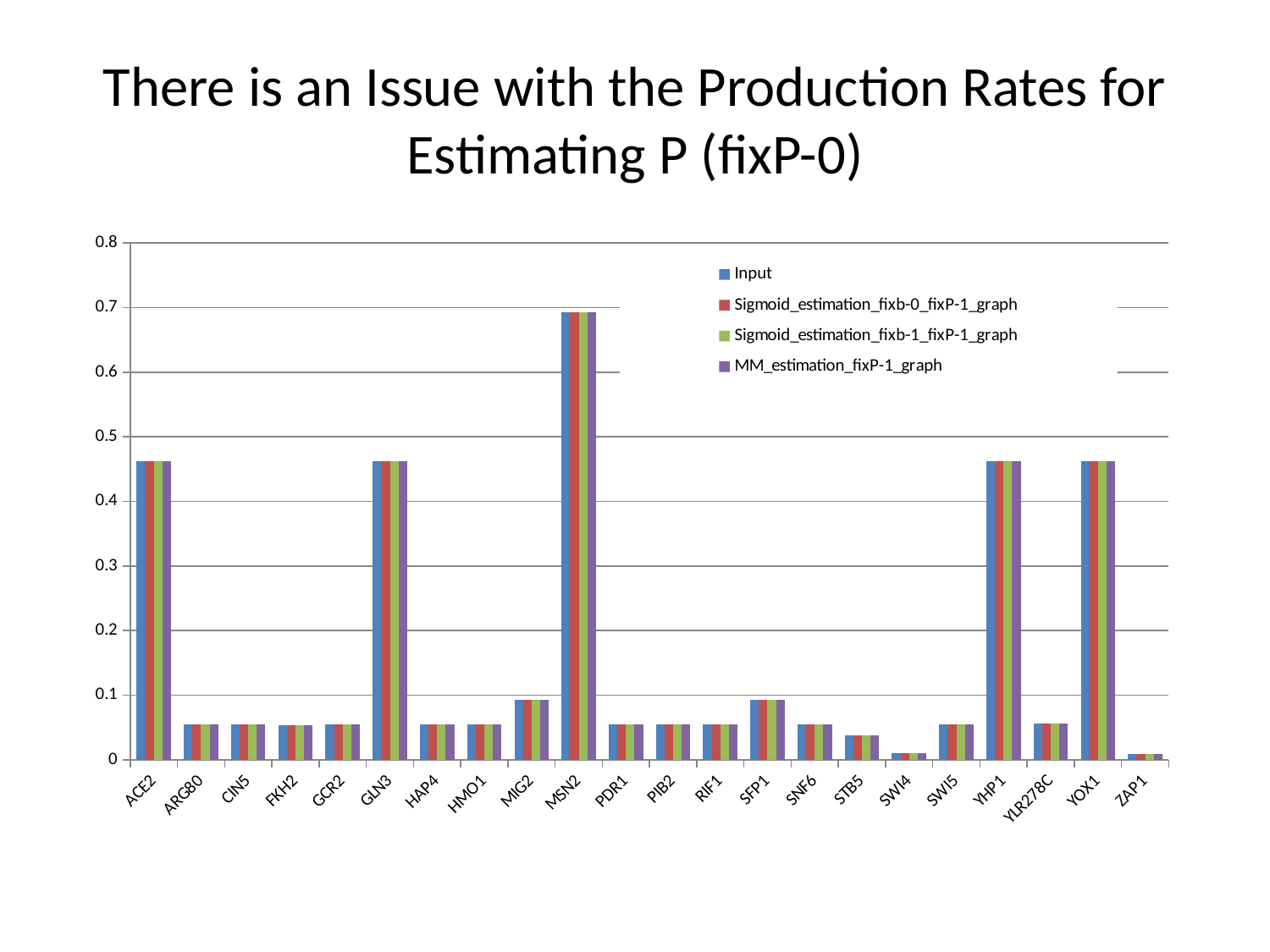
Is the Input value for GLN3 greater or less than 0.4? greater What kind of chart is shown on the slide? bar chart What is the title of the slide? There is an Issue with the Production Rates for Estimating P (fixP-0) Is the Input value for MIG2 greater or less than 0.1? less Which category has the highest values? MSN2 Which has the larger Input value, ACE2 or ARG80? ACE2 Is the Input value for MSN2 greater or less than 0.6? greater What is the first series listed in the legend? Input How many categories are shown on the x axis? 22 How many series does the legend list? 4 Which has the larger Input value, MSN2 or GLN3? MSN2